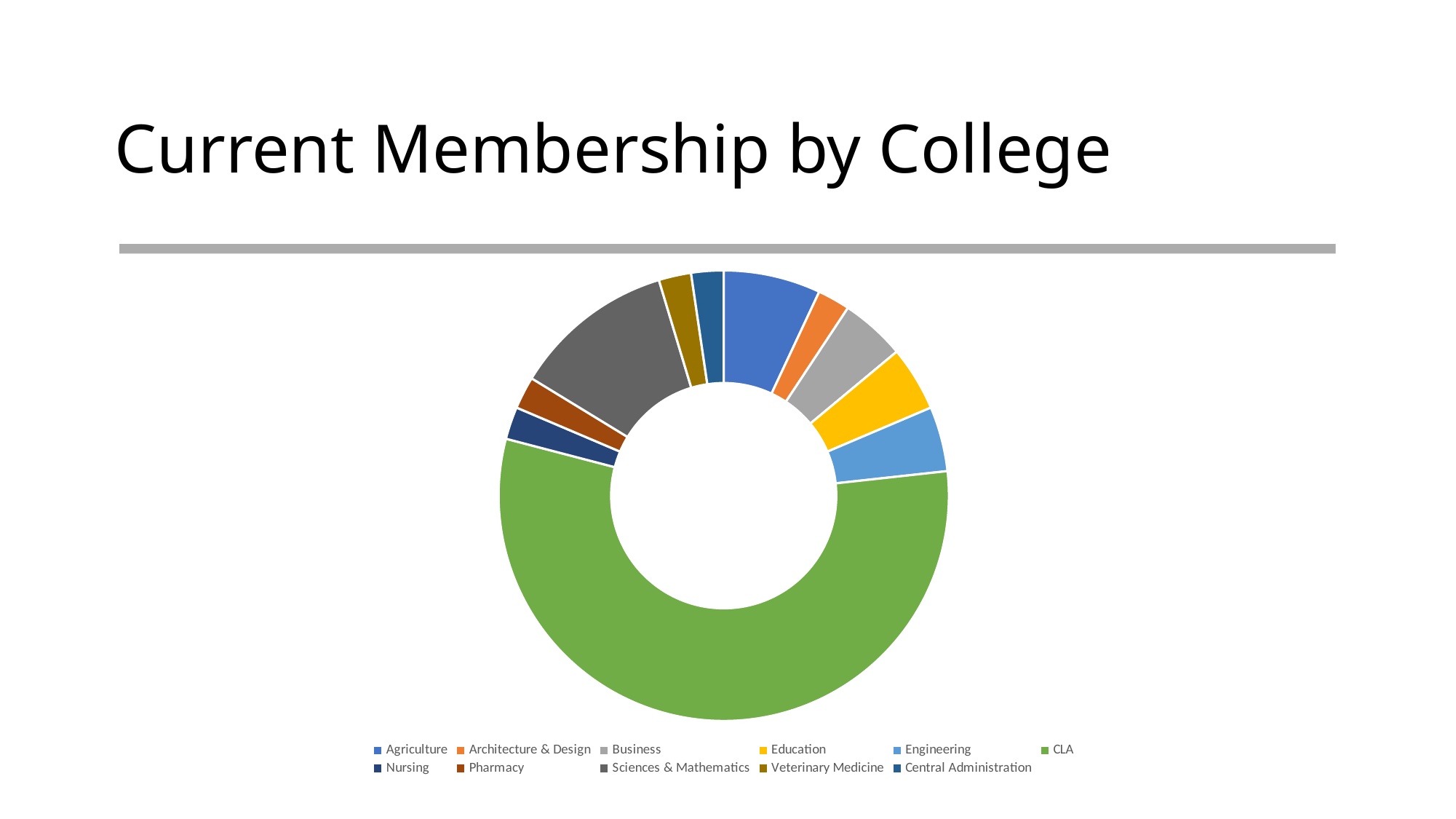
What colour represents CLA in the chart? Green Which is larger, the share for Sciences & Mathematics or the share for Engineering? Sciences & Mathematics What kind of chart is shown on the slide? Doughnut (pie) chart Which college has the largest share of current membership? CLA What is the title of the slide containing the chart? Current Membership by College Which is larger, the share for Sciences & Mathematics or the share for Business? Sciences & Mathematics How many colleges/categories does the chart's legend list? 11 Which is larger, the share for Agriculture or the share for Architecture & Design? Agriculture